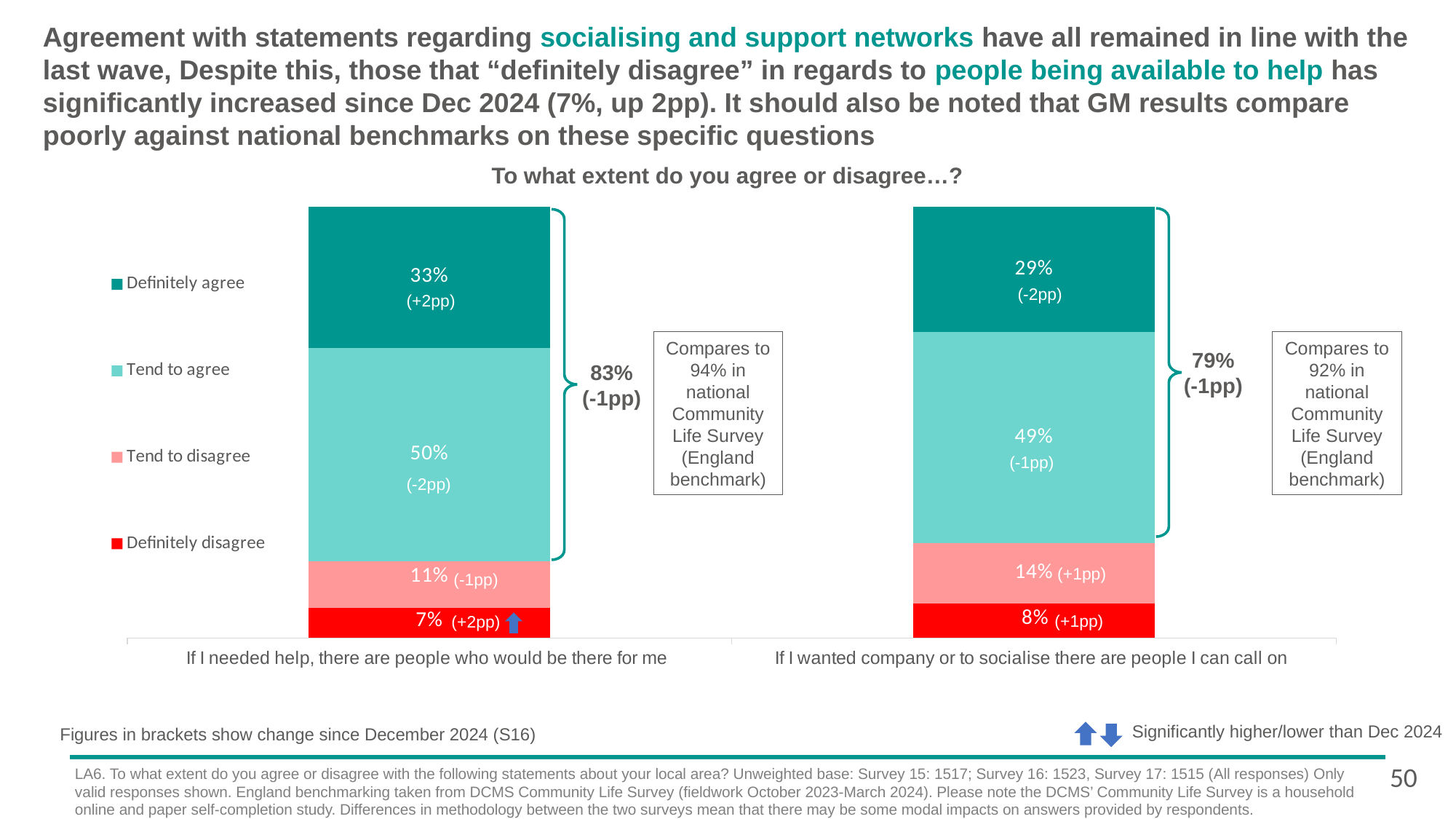
What type of chart is shown on the slide? Stacked bar chart What is the 'Tend to disagree' value for 'If I wanted company or to socialise there are people I can call on'? 14% What is the combined agreement shown for 'If I wanted company or to socialise there are people I can call on'? 79% What is the difference between the 'Definitely agree' values for the two statements? 4 percentage points What is the 'Definitely disagree' value for 'If I needed help, there are people who would be there for me'? 7% Which response category has the smallest share for 'If I wanted company or to socialise there are people I can call on'? Definitely disagree Which statement has the higher 'Definitely disagree' value? If I wanted company or to socialise there are people I can call on How many response categories does the legend list? 4 What is the combined agreement (Definitely agree plus Tend to agree) shown for 'If I needed help, there are people who would be there for me'? 83% Which response category has the largest share for 'If I needed help, there are people who would be there for me'? Tend to agree What percentage of respondents 'Definitely agree' that if they needed help, there are people who would be there for them? 33% What percentage 'Tend to agree' that if they wanted company or to socialise there are people they can call on? 49%